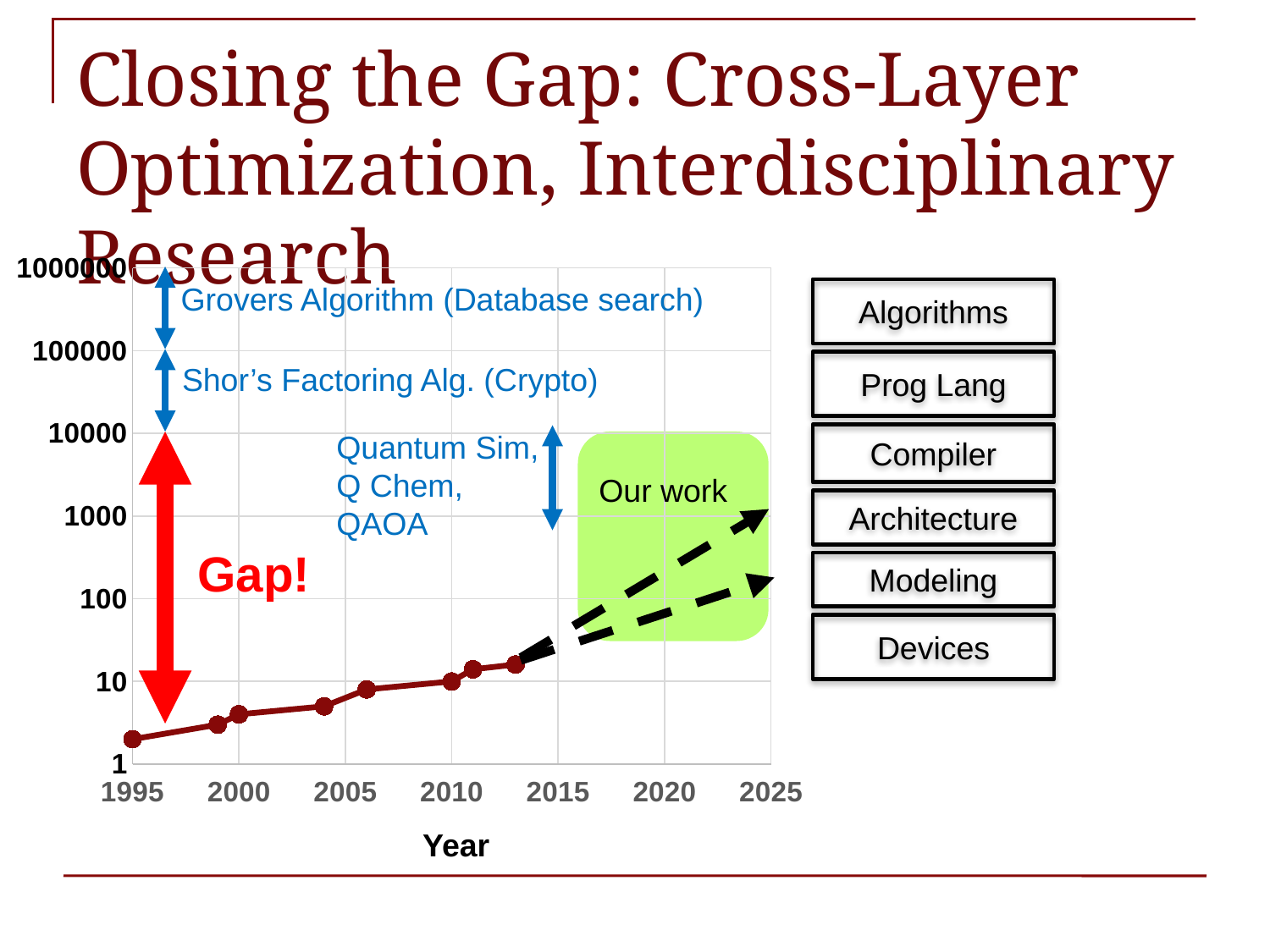
What is the highest tick value shown on the y axis? 1000000 Is the plotted value for 1995 greater or less than 10? less Which year has the lowest plotted value on the line? 1995 Which year has the highest plotted value on the line? 2013 Do the plotted values rise or fall as the year increases from 1995 to 2013? rise Is the plotted value for 2013 greater or less than 10? greater What kind of chart is shown on the slide? line chart What is the label of the x axis? Year Is the plotted value for 2013 greater or less than 100? less How many data points are plotted on the line? 8 Is the plotted value for 2013 larger or smaller than the value for 1995? larger